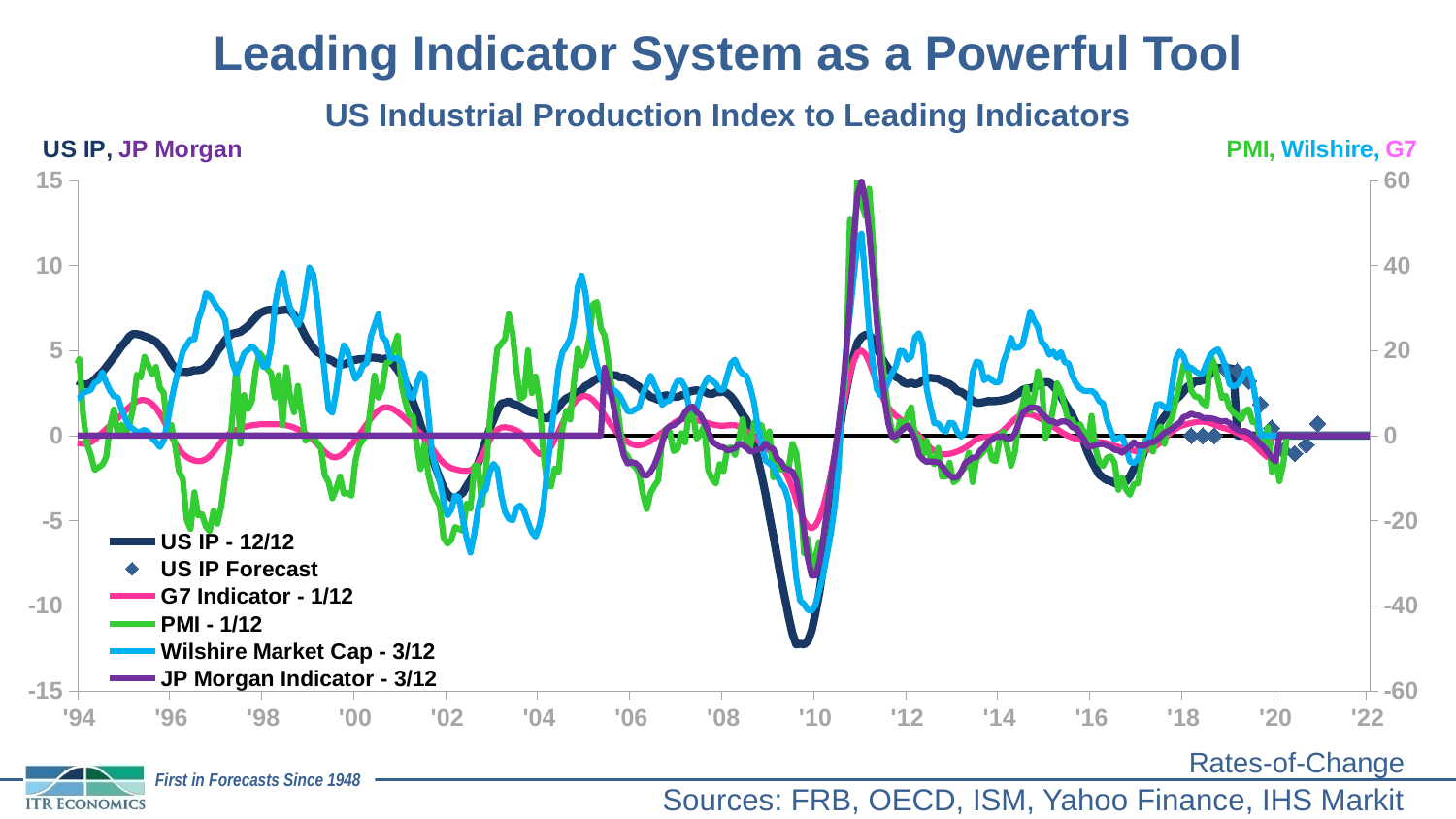
Is the lowest value of the Wilshire Market Cap - 3/12 line around 2009 greater or less than -20 on the right axis? less What is the subtitle of the chart? US Industrial Production Index to Leading Indicators How many year labels are shown along the x axis? 15 Is the lowest value of the US IP - 12/12 line, around 2009-2010, greater or less than -10 on the left axis? less What kind of chart is shown on the slide? line chart Does the US IP - 12/12 line rise or fall between 2018 and 2020? fall Does the US IP - 12/12 line rise or fall between its 2009 low and 2011? rise Is the peak of the US IP - 12/12 line around 1998 greater or less than 5 on the left axis? greater Which series in the legend is drawn with diamond markers rather than a line? US IP Forecast Which series reaches a higher peak around 2011, US IP - 12/12 or G7 Indicator - 1/12? US IP - 12/12 How many series does the legend list? 6